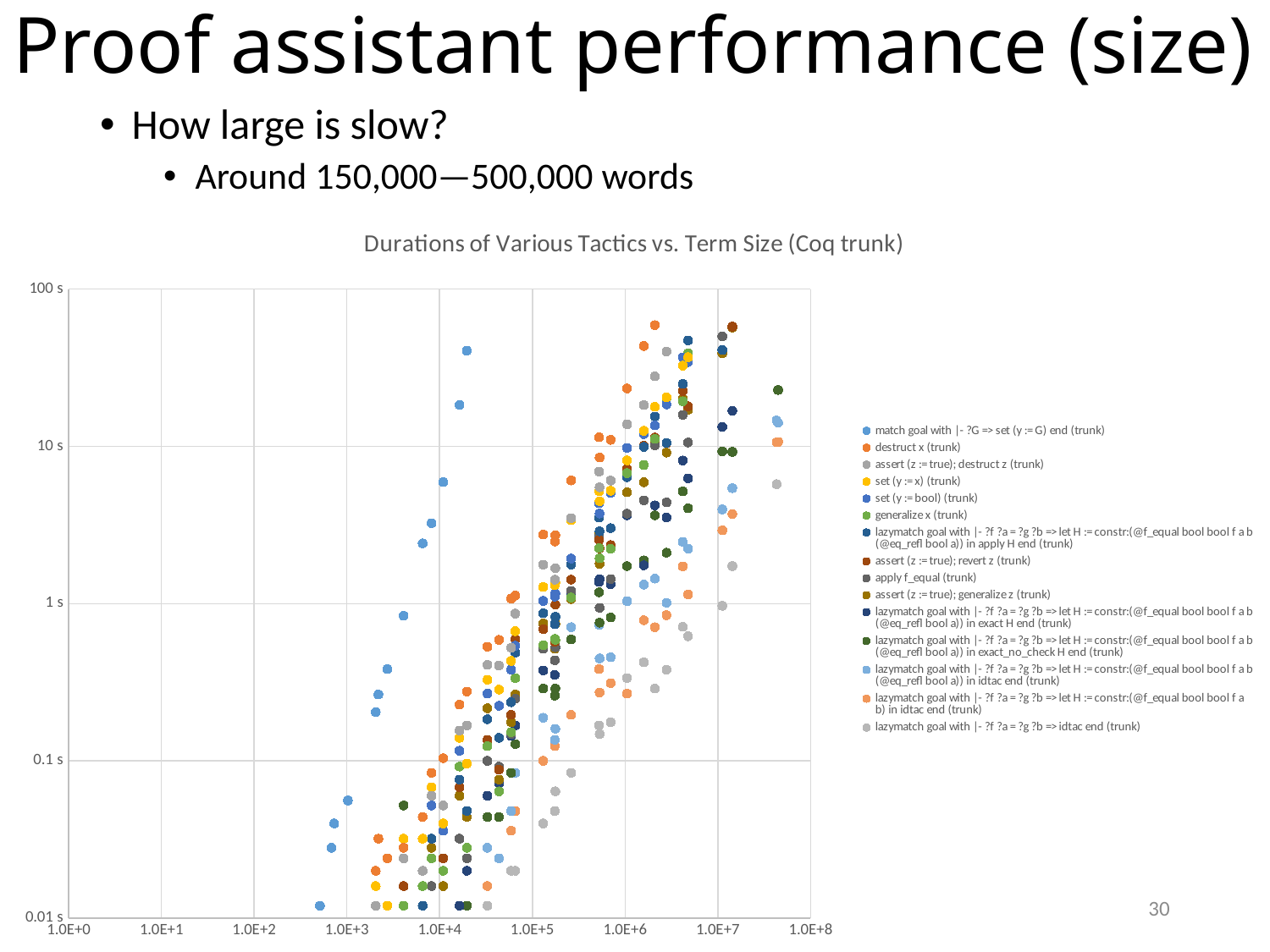
Which series is listed first in the chart's legend? match goal with |- ?G => set (y := G) end (trunk) Do the tactic durations generally rise or fall as term size increases along the x axis? rise How many series does the chart's legend list? 15 What is the title of the chart? Durations of Various Tactics vs. Term Size (Coq trunk) What kind of chart is shown on the slide? scatter chart